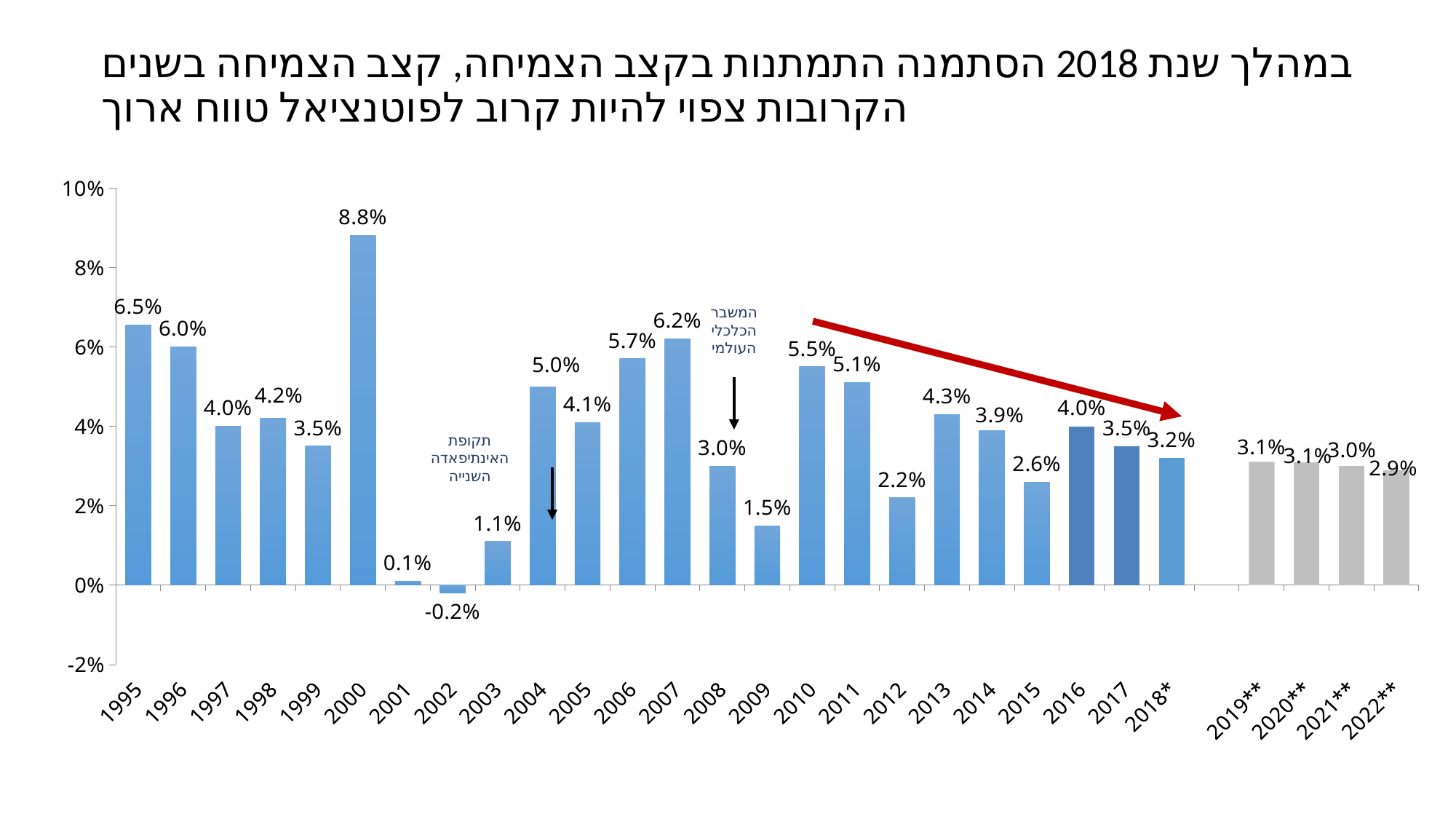
Which is larger, the value for 2010 or the value for 2011? 2010 What kind of chart is shown on the slide? bar chart Do the values rise or fall from 2019** to 2022**? fall What is the value for 2000? 8.8% How many years (bars) are shown on the chart? 28 What is the difference between the values for 2007 and 2008? 3.2% What is the value for 2002? -0.2% What is the value for 2018*? 3.2% Which year has the lowest value? 2002 What is the value for 2022**? 2.9% Which year has the highest value? 2000 Is the value for 2006 greater or less than 4%? greater